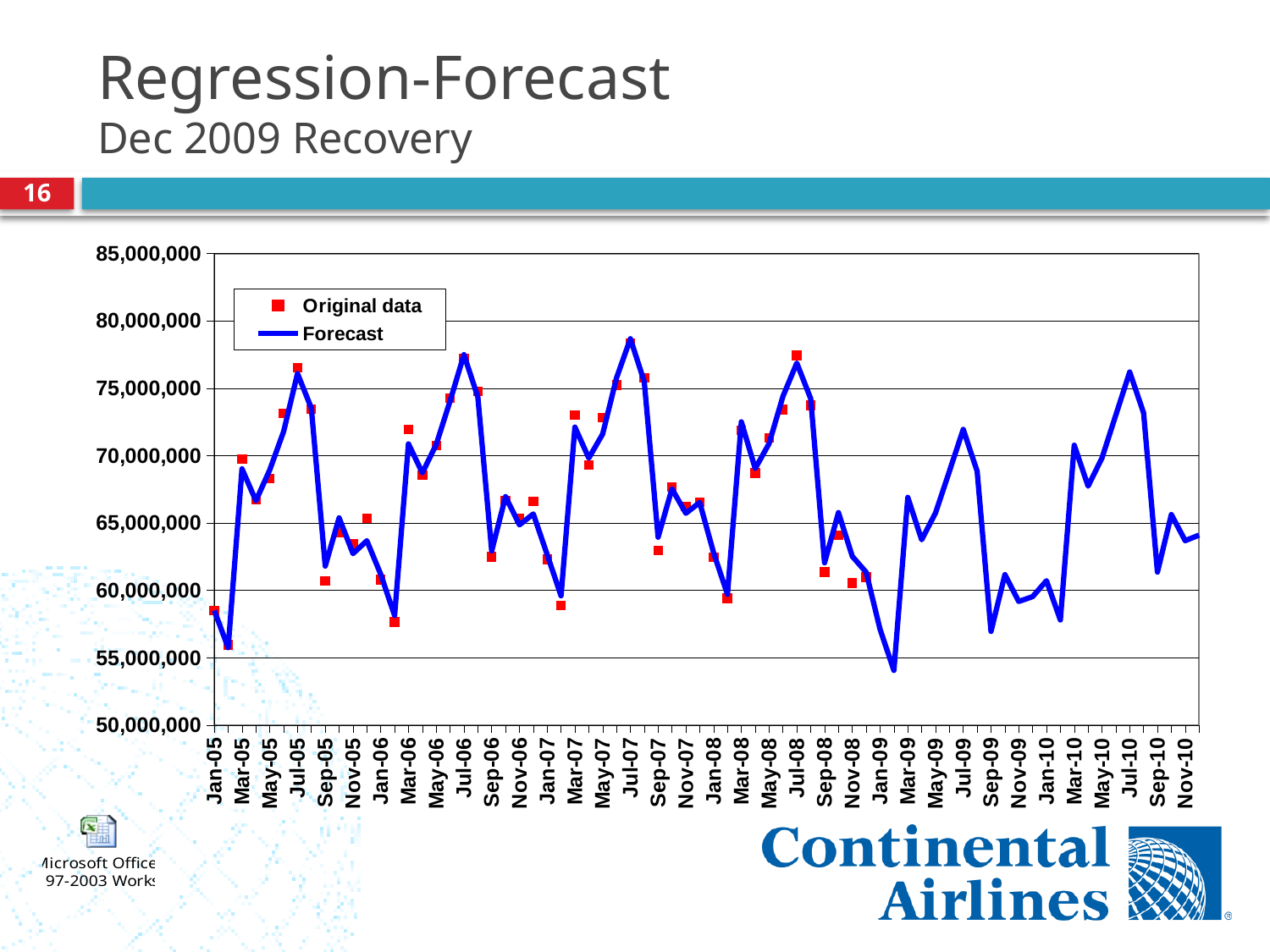
In which month does the Forecast line reach its lowest value? Feb-09 Is the Forecast value for Jan-09 greater or less than 55,000,000? greater Is the Forecast value for Jul-07 greater or less than 75,000,000? greater How many series does the legend list? 2 Is the Original data value for Jul-05 greater or less than 75,000,000? greater Does the Forecast line rise or fall from Jul-08 to Jan-09? fall What is the highest value shown on the y axis? 85,000,000 Which is higher, the Forecast value for Jul-07 or the Forecast value for Jul-09? Jul-07 In which month does the Forecast line reach its highest value? Jul-07 What kind of chart is shown on the slide? line chart What are the two series named in the legend? Original data and Forecast